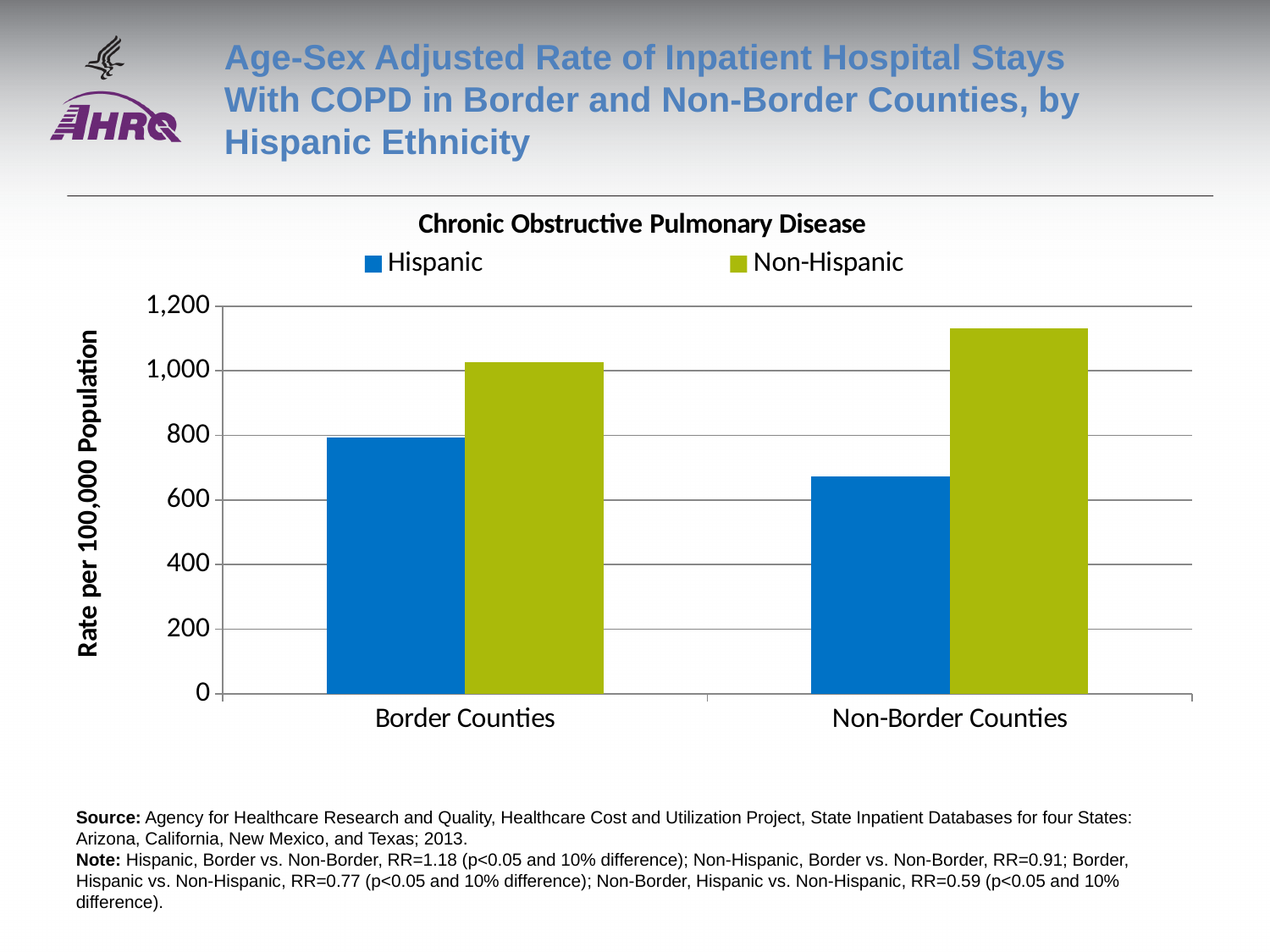
Is the Non-Hispanic value for Border Counties greater or less than 1,000? greater Is the Non-Hispanic value for Non-Border Counties greater or less than 1,000? greater In Border Counties, which is larger, the Hispanic or the Non-Hispanic rate? Non-Hispanic What is the label of the y axis? Rate per 100,000 Population Which has the larger Hispanic rate, Border Counties or Non-Border Counties? Border Counties How many categories are shown on the x axis? 2 Which bar is the lowest in the chart? Hispanic, Non-Border Counties How many series does the legend list? 2 Which bar is the highest in the chart? Non-Hispanic, Non-Border Counties What kind of chart is shown on the slide? bar chart Is the Hispanic value for Non-Border Counties greater or less than 600? greater